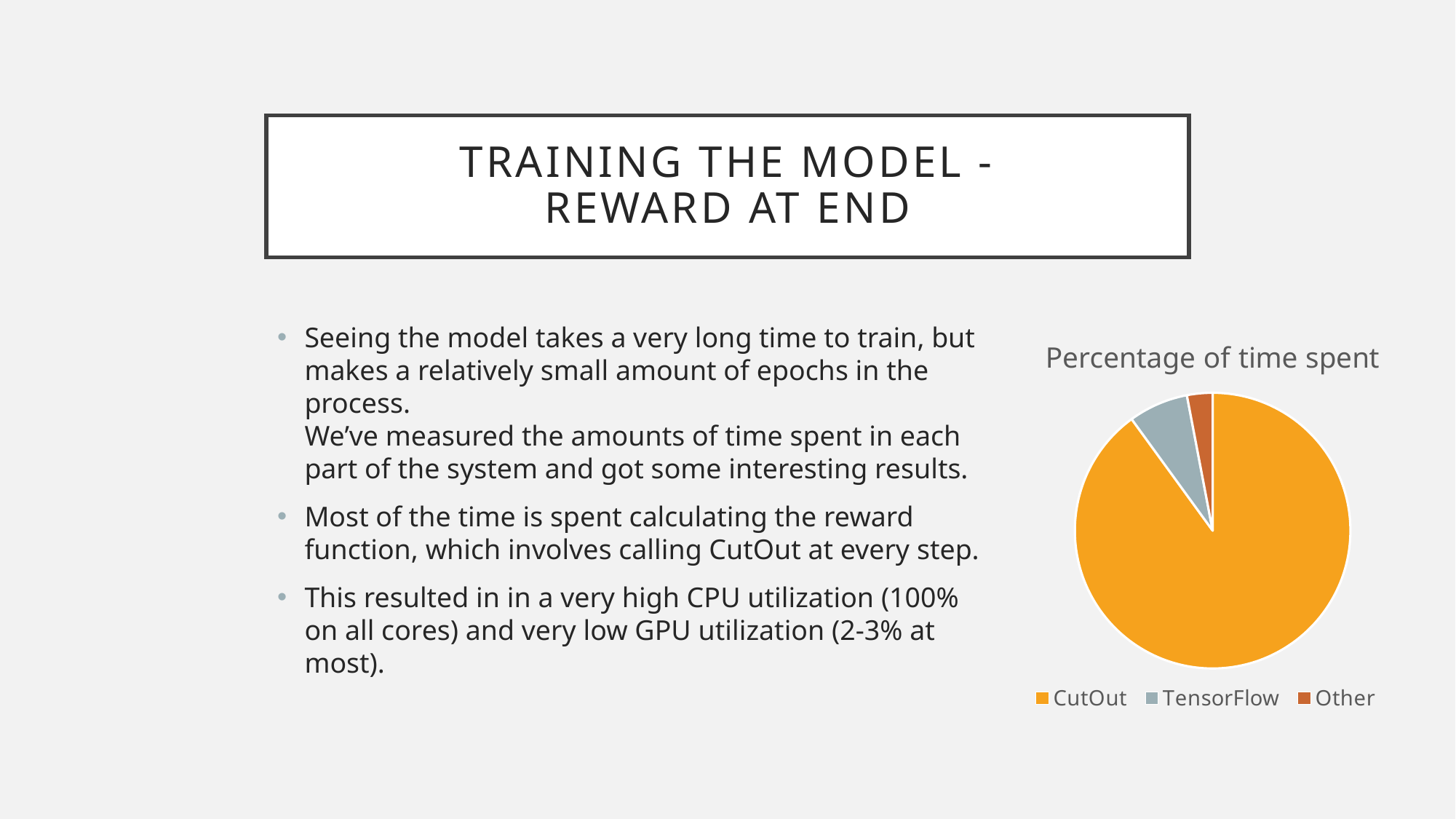
Which slice is larger, CutOut or TensorFlow? CutOut Which category takes up the largest share of the pie chart? CutOut What kind of chart is shown on the slide? pie chart How many slices does the pie chart have? 3 Which category takes up the smallest share of the pie chart? Other What colour is the CutOut slice in the pie chart? orange How many entries does the chart legend list? 3 Which slice is larger, TensorFlow or Other? TensorFlow What is the title of the chart? Percentage of time spent